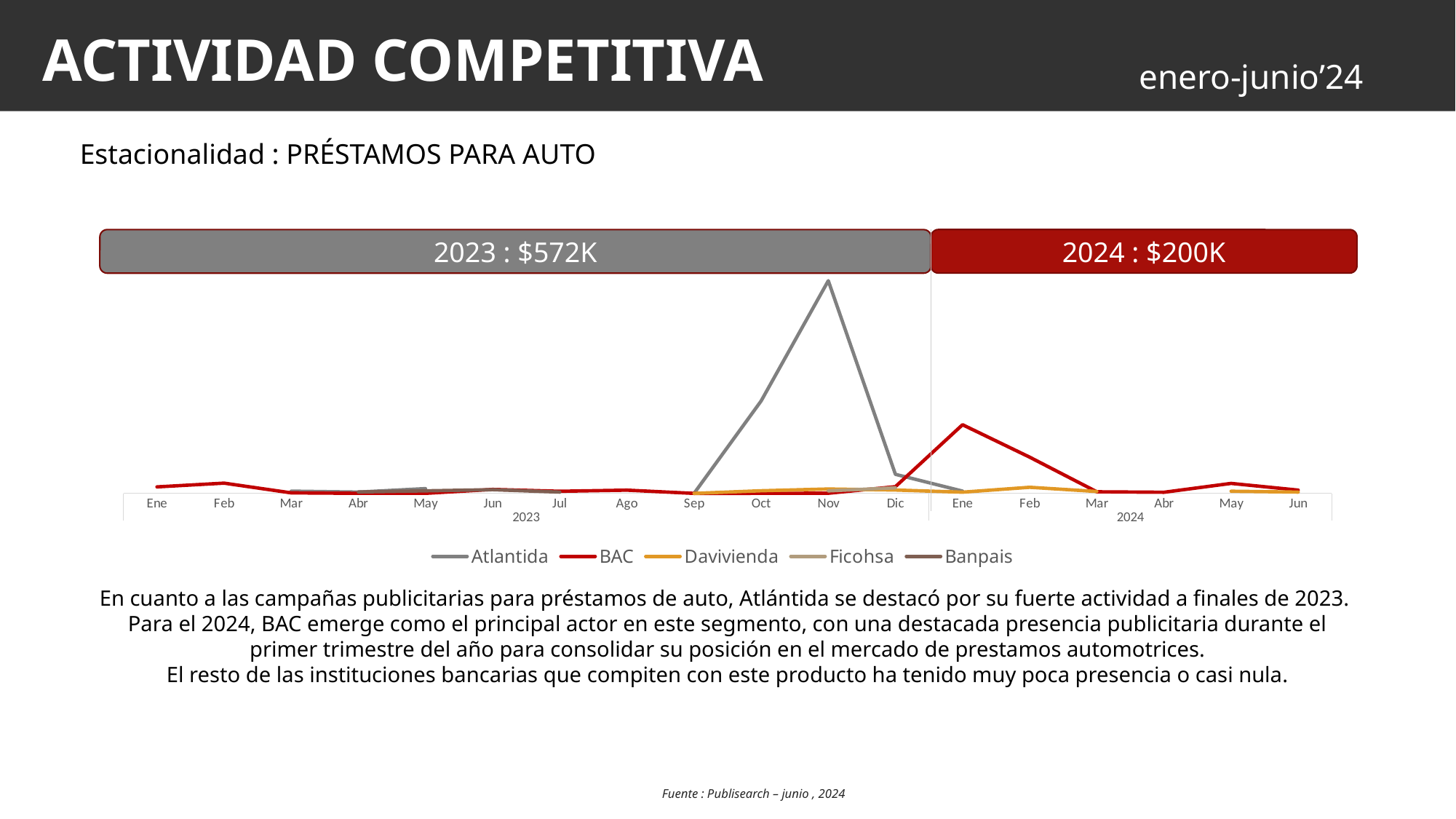
In which month does Atlantida reach its peak? Nov 2023 Which series is drawn in red? BAC How many series does the legend list? 5 Does the BAC line rise or fall from Ene 2024 to Mar 2024? Fall Which is larger: Atlantida's peak in Nov 2023 or BAC's peak in Ene 2024? Atlantida's peak in Nov 2023 What total is shown in the banner for 2023? $572K Does the Atlantida line rise or fall from Sep 2023 to Nov 2023? Rise In which month does BAC reach its highest point? Ene 2024 What total is shown in the banner for 2024? $200K How many months are plotted along the x axis? 18 Which series reaches the highest point on the chart? Atlantida What kind of chart is shown on the slide? Line chart